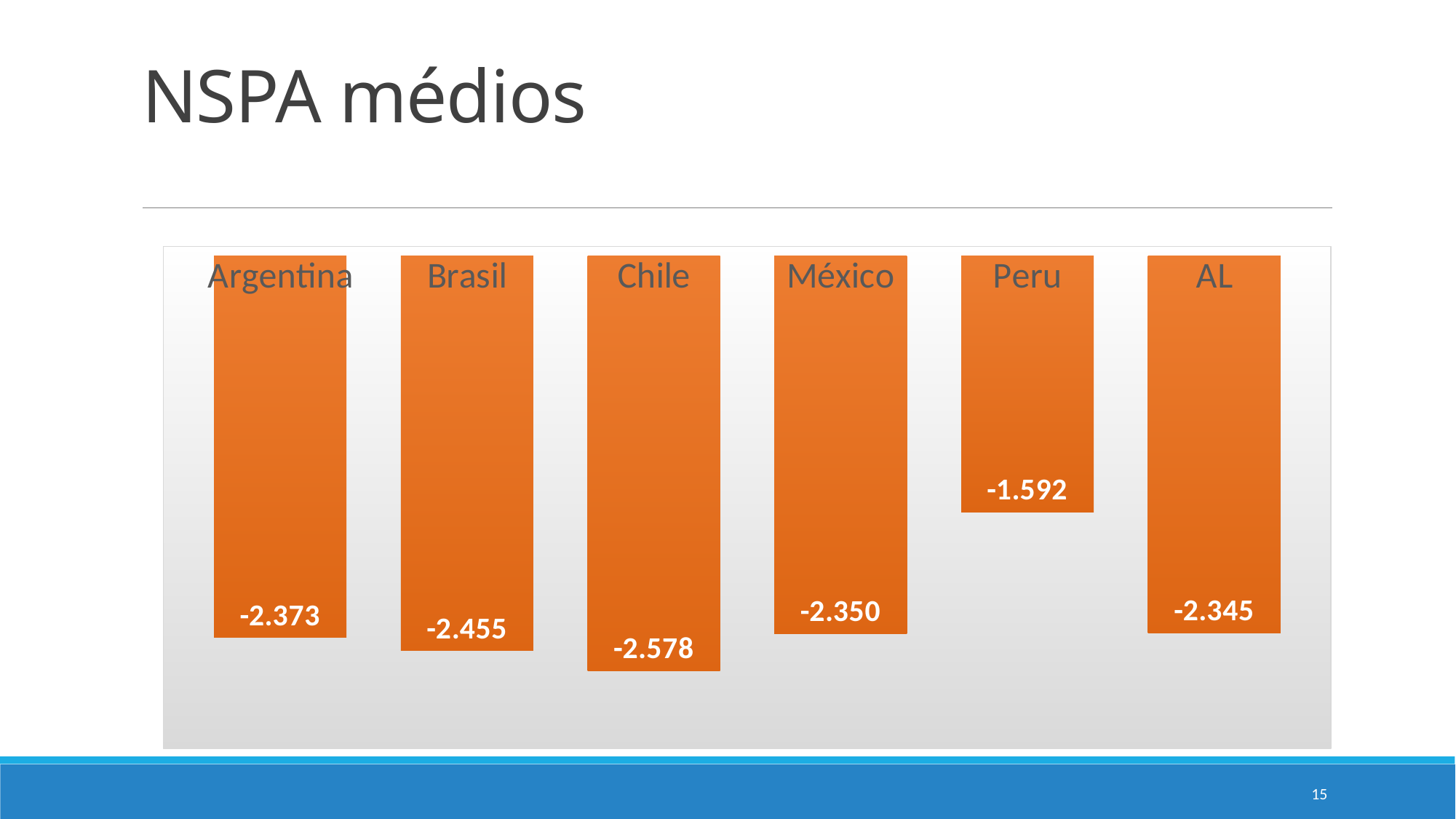
Which category has the highest value? Peru What is the value for Brasil? -2.455 What is the value for Chile? -2.578 What is the difference between the values for Argentina and Brasil? 0.082 What kind of chart is shown on the slide? Bar chart Which has the larger value, Argentina or Chile? Argentina Which category has the lowest value? Chile What is the value for AL? -2.345 What is the difference between the values for Chile and Peru? 0.986 How many categories are shown in the chart? 6 What is the title of the slide? NSPA médios What is the value for Peru? -1.592